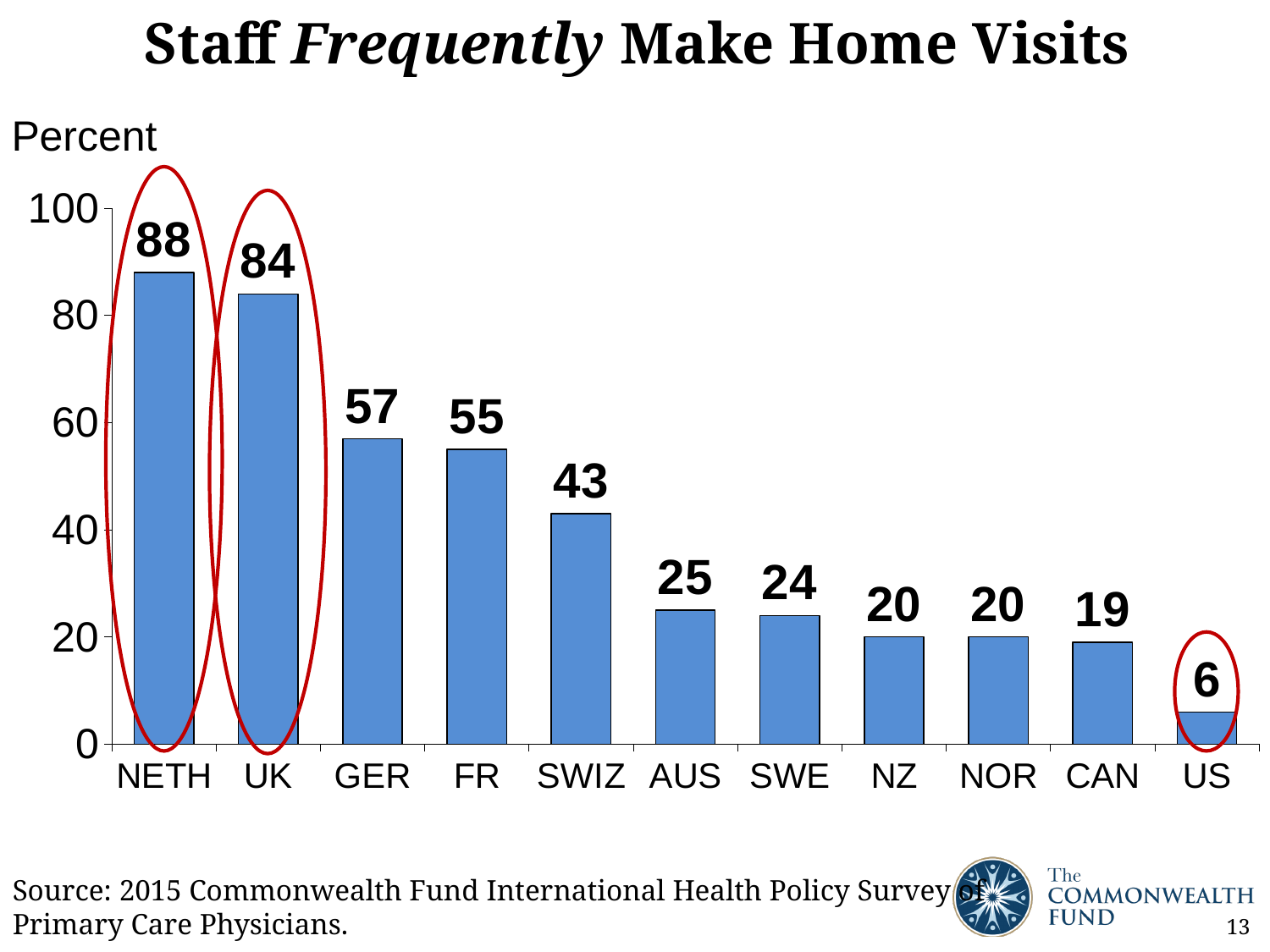
Which country has the highest value? NETH What is the value for NETH? 88 Do the values rise or fall from left to right along the x axis? fall What is the difference between the values for GER and US? 51 Which country has the lowest value? US How many countries are shown on the chart? 11 What is the title of the chart? Staff Frequently Make Home Visits What kind of chart is this? bar chart Which is larger, the value for FR or the value for AUS? FR What is the difference between the values for NETH and UK? 4 What is the value for SWIZ? 43 What is the value for US? 6